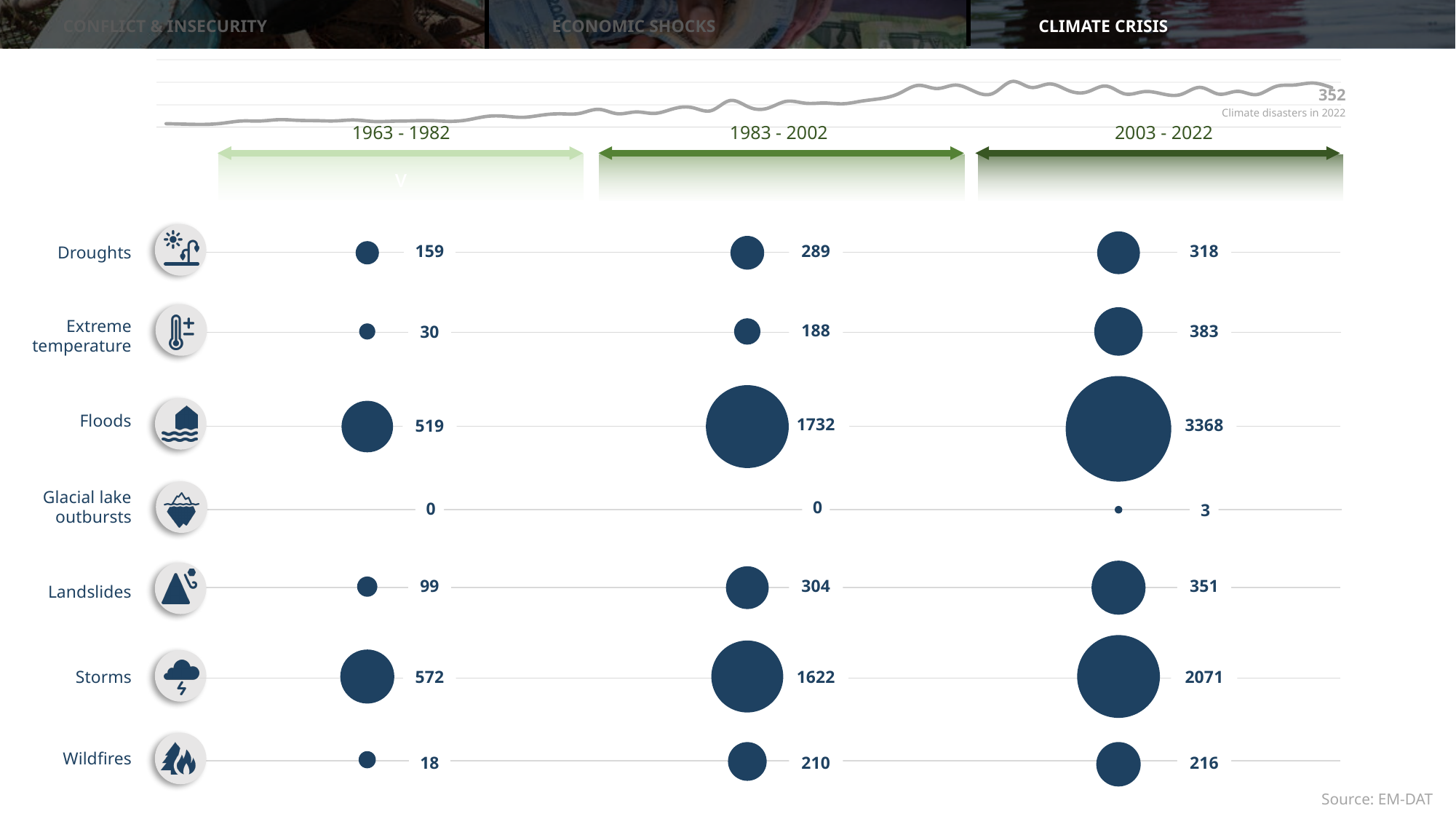
What is the difference between the number of floods in 2003 - 2022 and in 1983 - 2002? 1636 Do the values for droughts rise or fall from the 1963 - 1982 period to the 2003 - 2022 period? Rise What is the value for extreme temperature in the 1983 - 2002 period? 188 What is the source cited for the chart data? EM-DAT According to the line chart at the top, how many climate disasters were there in 2022? 352 How many floods were recorded in the 2003 - 2022 period? 3368 How many time periods does the chart compare? 3 Which disaster type has the lowest value in the 1963 - 1982 period? Glacial lake outbursts What is the value for storms in the 1963 - 1982 period? 572 Which is larger: wildfires in 1983 - 2002 or wildfires in 2003 - 2022? Wildfires in 2003 - 2022 How many disaster types are listed in the chart? 7 Which disaster type has the highest value in the 2003 - 2022 period? Floods